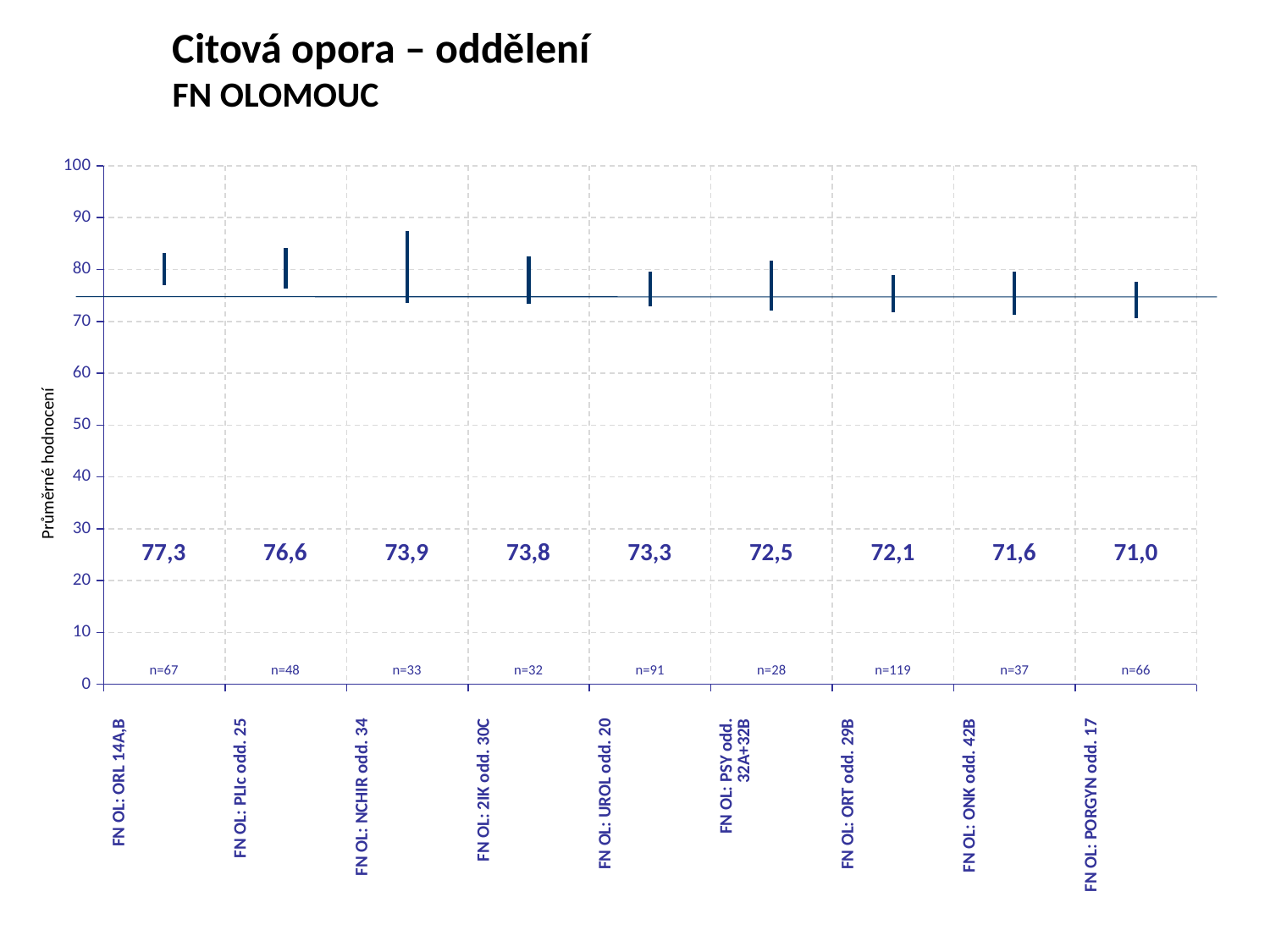
What is the average rating (průměrné hodnocení) for FN OL: ORL 14A,B? 77,3 What is the label of the vertical axis? Průměrné hodnocení What is the number of respondents (n) for FN OL: ORT odd. 29B? 119 How many departments are shown on the chart? 9 What is the average rating shown for FN OL: UROL odd. 20? 73,3 Do the average ratings rise or fall from left to right across the departments? fall What is the average rating shown for FN OL: PORGYN odd. 17? 71,0 Which has a higher average rating: FN OL: NCHIR odd. 34 or FN OL: ORT odd. 29B? FN OL: NCHIR odd. 34 What is the difference between the average ratings of FN OL: PLIc odd. 25 and FN OL: 2IK odd. 30C? 2,8 Which department has the lowest average rating? FN OL: PORGYN odd. 17 Which department has the highest average rating? FN OL: ORL 14A,B What is the difference between the average ratings of FN OL: ORL 14A,B and FN OL: PORGYN odd. 17? 6,3